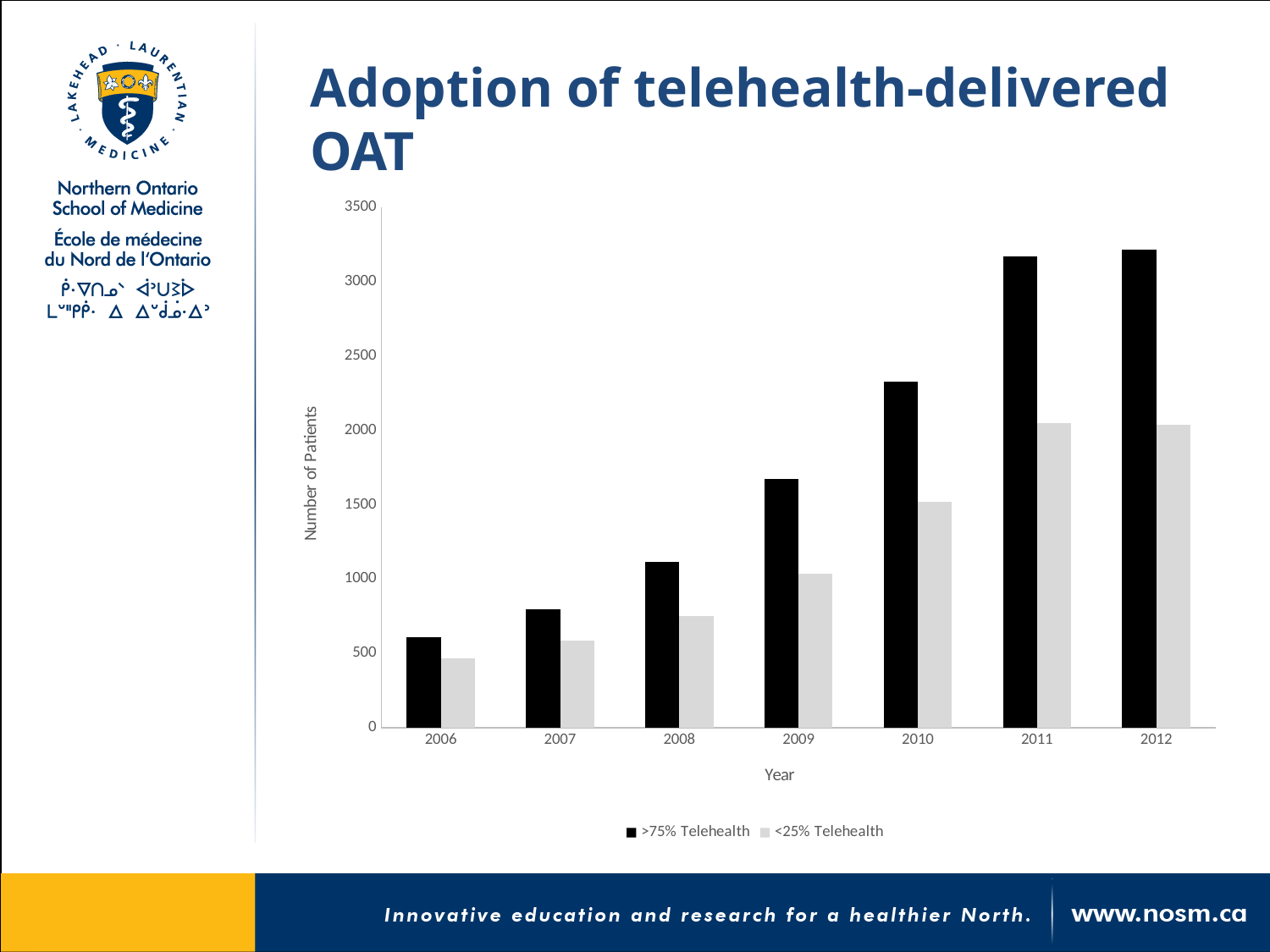
Is the value for <25% Telehealth in 2008 greater or less than 1000? less What is the label of the y axis? Number of Patients Is the value for >75% Telehealth in 2011 greater or less than 3000? greater How many series does the legend list? 2 Which year has the lowest value for >75% Telehealth? 2006 Is the value for >75% Telehealth in 2009 greater or less than 1500? greater How many years are shown on the x axis? 7 In 2010, which series has the larger value, >75% Telehealth or <25% Telehealth? >75% Telehealth Which year has the lowest value for <25% Telehealth? 2006 Do the values for >75% Telehealth rise or fall from 2006 to 2012? rise What kind of chart is shown on the slide? bar chart